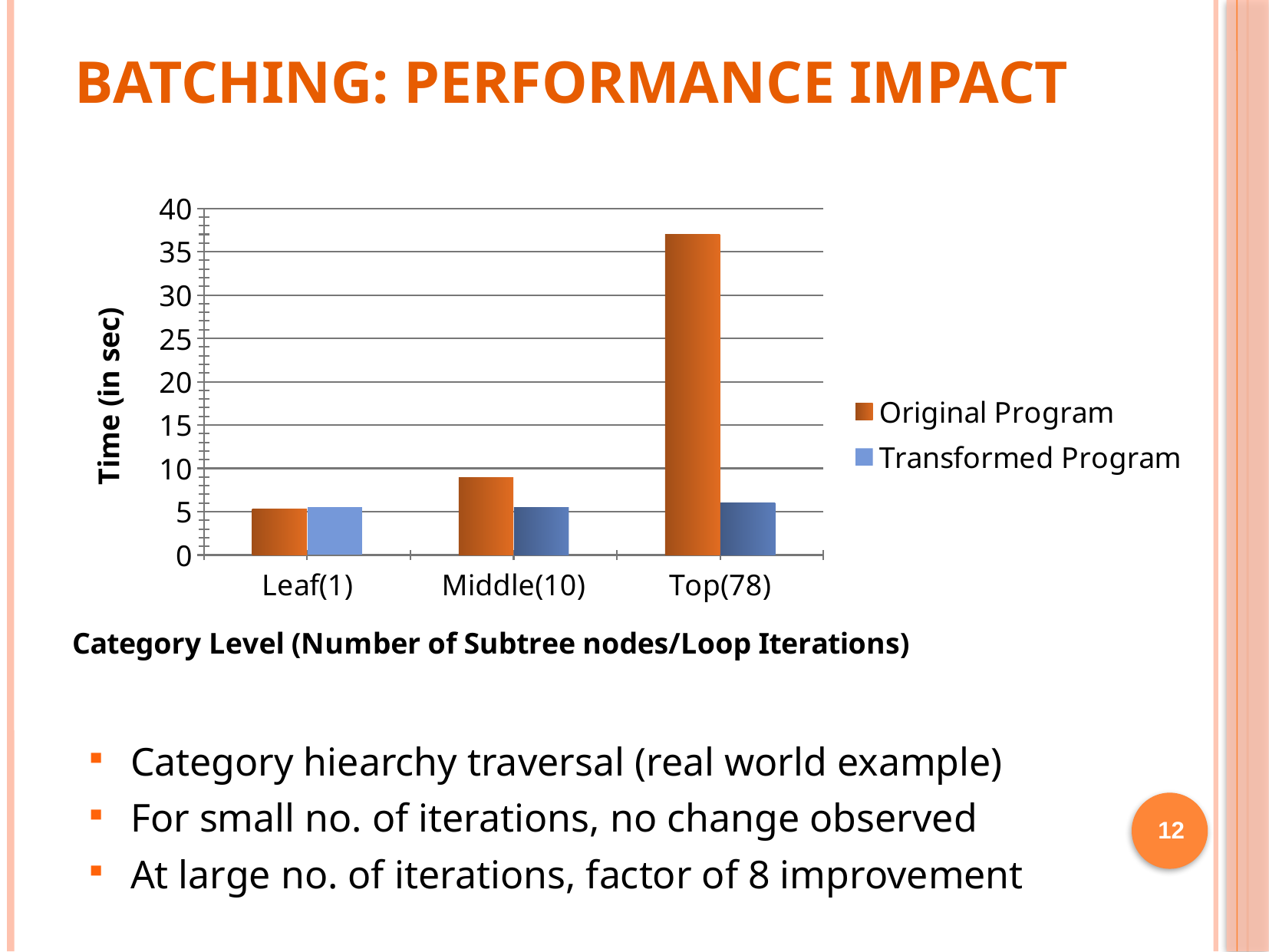
For Top(78), which is larger: Original Program or Transformed Program? Original Program For Middle(10), which is larger: Original Program or Transformed Program? Original Program What kind of chart is shown on the slide? bar chart Which category has the lowest value for Original Program? Leaf(1) Is the Original Program value for Top(78) greater or less than 30? greater What is the label of the y axis? Time (in sec) Which category has the highest value for Original Program? Top(78) How many categories are shown on the x axis? 3 Is the Original Program value for Middle(10) greater or less than 15? less Is the Transformed Program value for Top(78) greater or less than 10? less Do the Original Program values rise or fall from Leaf(1) to Top(78)? rise How many series does the legend list? 2